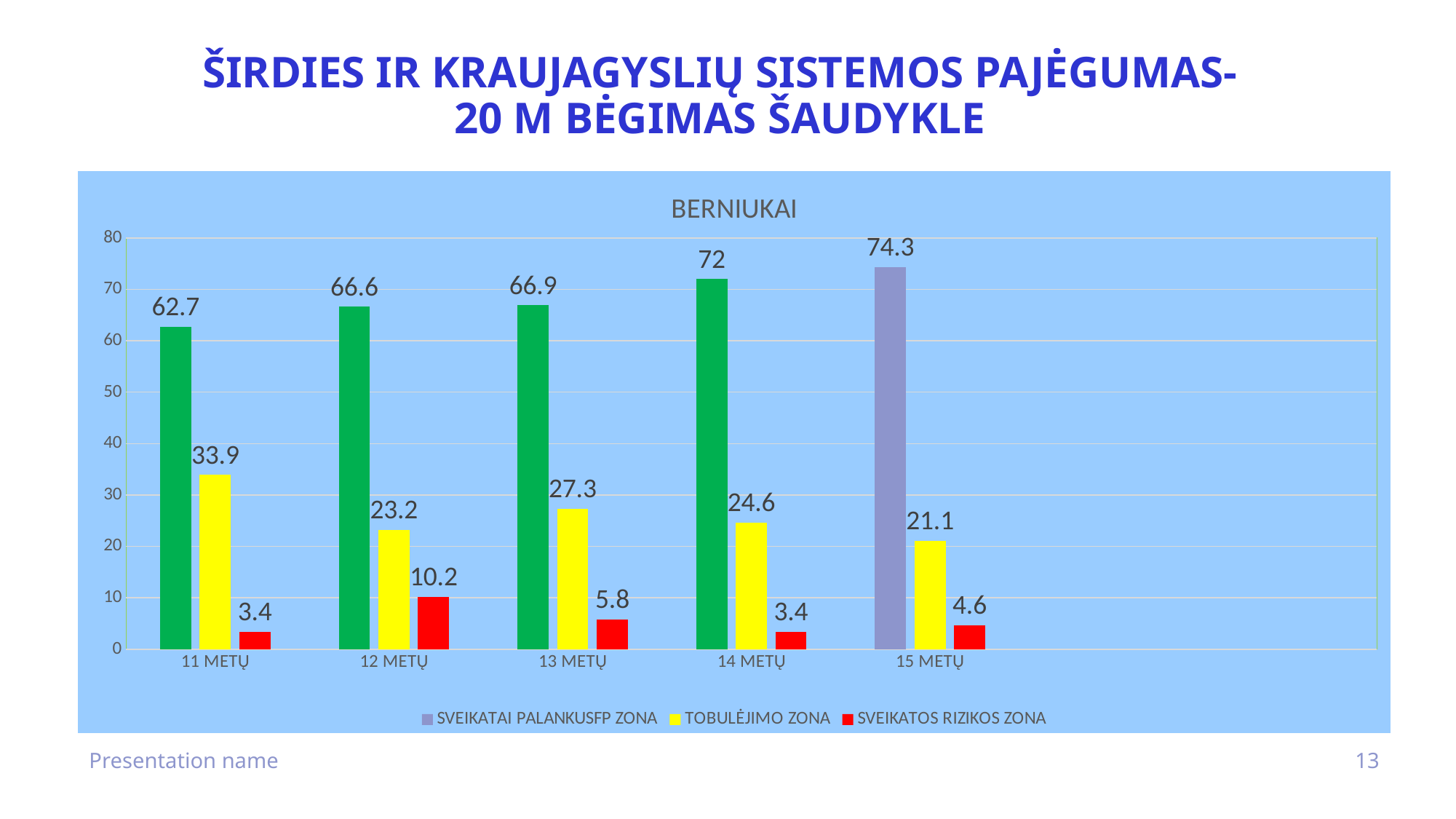
What is the title of the chart? BERNIUKAI How many age groups are shown on the x axis? 5 What type of chart is shown? Bar chart What is the value of TOBULĖJIMO ZONA for 11 METŲ? 33.9 Which age group has the highest value for SVEIKATAI PALANKUSFP ZONA? 15 METŲ How many series does the legend list? 3 What is the value of SVEIKATOS RIZIKOS ZONA for 12 METŲ? 10.2 What is the difference between the SVEIKATAI PALANKUSFP ZONA values for 15 METŲ and 11 METŲ? 11.6 Which age group has the highest value for SVEIKATOS RIZIKOS ZONA? 12 METŲ What is the value of SVEIKATAI PALANKUSFP ZONA for 14 METŲ? 72 Which age group has the lowest value for TOBULĖJIMO ZONA? 15 METŲ Which is larger: TOBULĖJIMO ZONA for 13 METŲ or for 14 METŲ? 13 METŲ